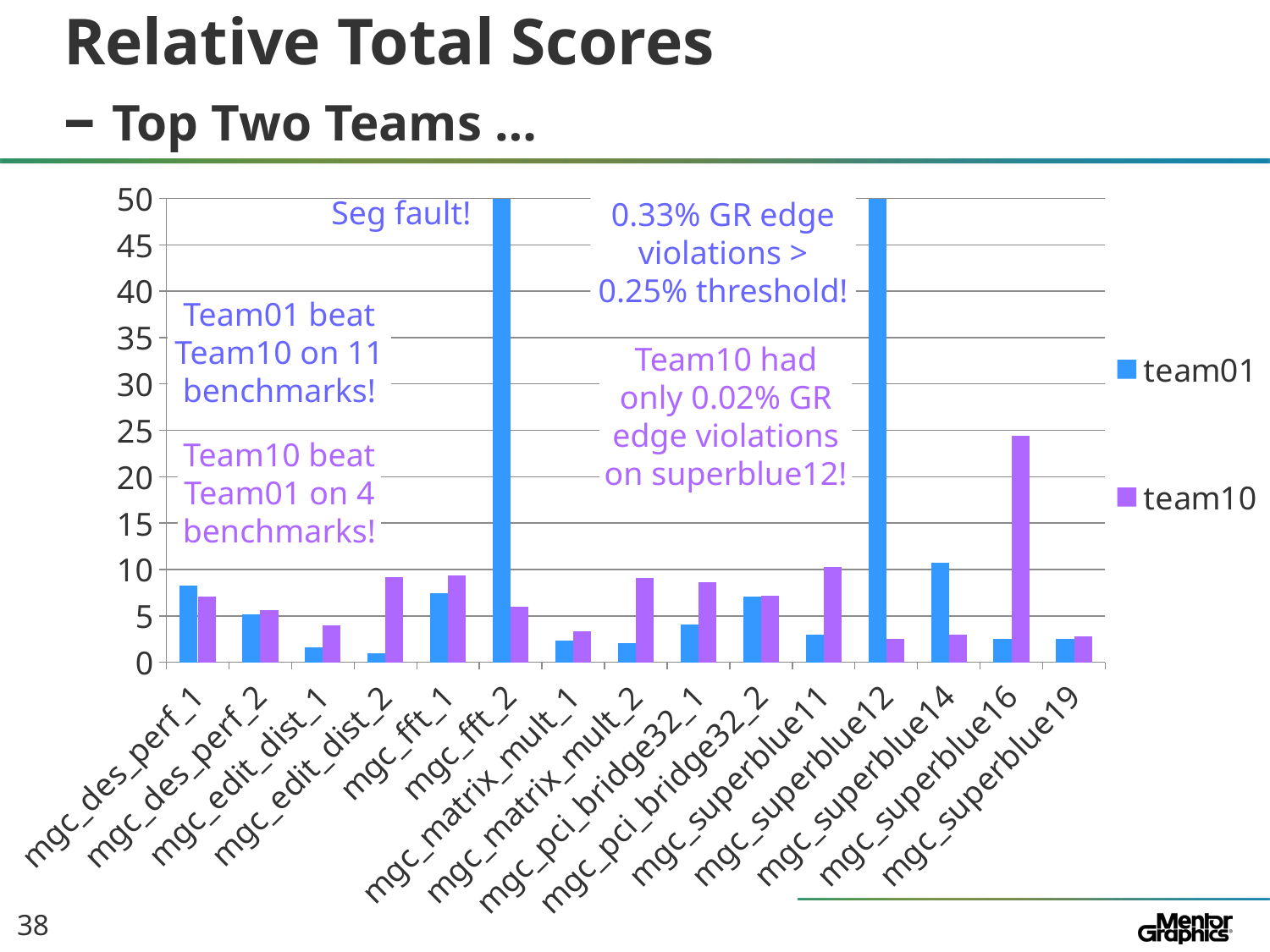
What kind of chart is shown on the slide? bar chart Is the team01 value for mgc_superblue14 greater or less than 5? greater Which benchmark has the highest team10 value? mgc_superblue16 For mgc_superblue11, which team has the larger value, team01 or team10? team10 Is the team10 value for mgc_fft_2 greater or less than 10? less What are the two entries in the chart legend? team01 and team10 How many benchmark categories are plotted along the x axis? 15 For mgc_superblue14, which team has the larger value, team01 or team10? team01 Is the team10 value for mgc_superblue16 greater or less than 20? greater For mgc_edit_dist_2, which team has the larger value, team01 or team10? team10 How many series does the legend list? 2